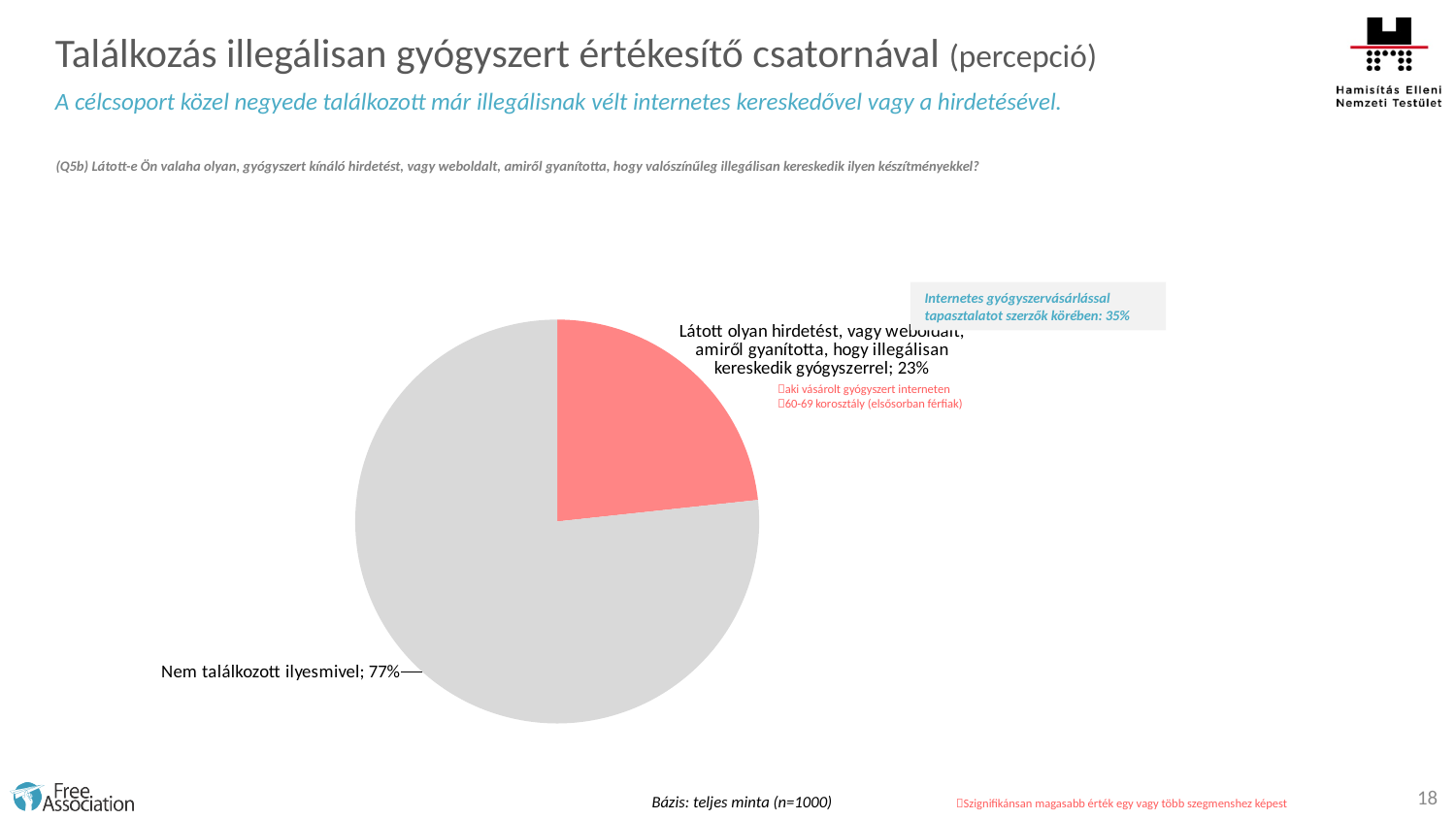
What is the difference in percentage points between the "Nem találkozott ilyesmivel" slice and the "Látott olyan hirdetést..." slice? 54 What colour is the "Látott olyan hirdetést..." slice? red Which is larger: the "Nem találkozott ilyesmivel" slice or the "Látott olyan hirdetést..." slice? Nem találkozott ilyesmivel Is the share for "Látott olyan hirdetést..." greater or less than 25%? less What kind of chart is shown on the slide? pie chart What is the sample size (n) stated in the base note below the chart? n=1000 Which slice of the pie chart is the largest? Nem találkozott ilyesmivel What share of the pie is labelled "Nem találkozott ilyesmivel"? 77% Which slice of the pie chart is the smallest? Látott olyan hirdetést, vagy weboldalt, amiről gyanította, hogy illegálisan kereskedik gyógyszerrel What colour is the "Nem találkozott ilyesmivel" slice? grey How many slices does the pie chart have? 2 What share of the pie is labelled "Látott olyan hirdetést, vagy weboldalt, amiről gyanította, hogy illegálisan kereskedik gyógyszerrel"? 23%